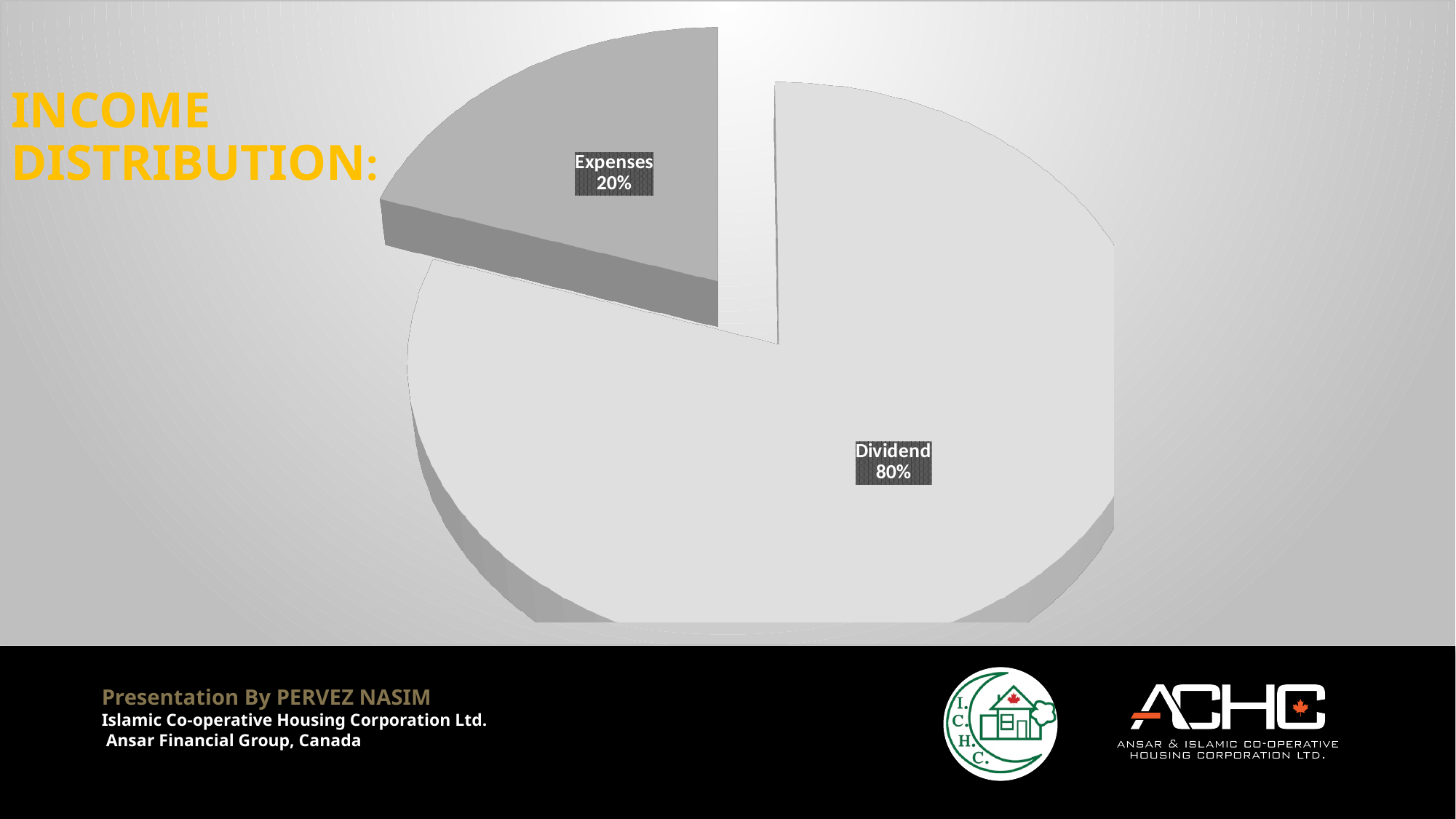
Which slice of the pie is the largest? Dividend What share of the pie does Dividend represent? 80% What is the difference in percentage points between the Dividend and Expenses slices? 60 Which slice of the pie is the smallest? Expenses How many slices does the pie chart have? 2 Which slice is pulled out (exploded) from the rest of the pie? Expenses What kind of chart is shown on the slide? Pie chart What share of the pie does Expenses represent? 20% What is the title shown next to the chart? INCOME DISTRIBUTION: Which is larger, the Dividend slice or the Expenses slice? Dividend